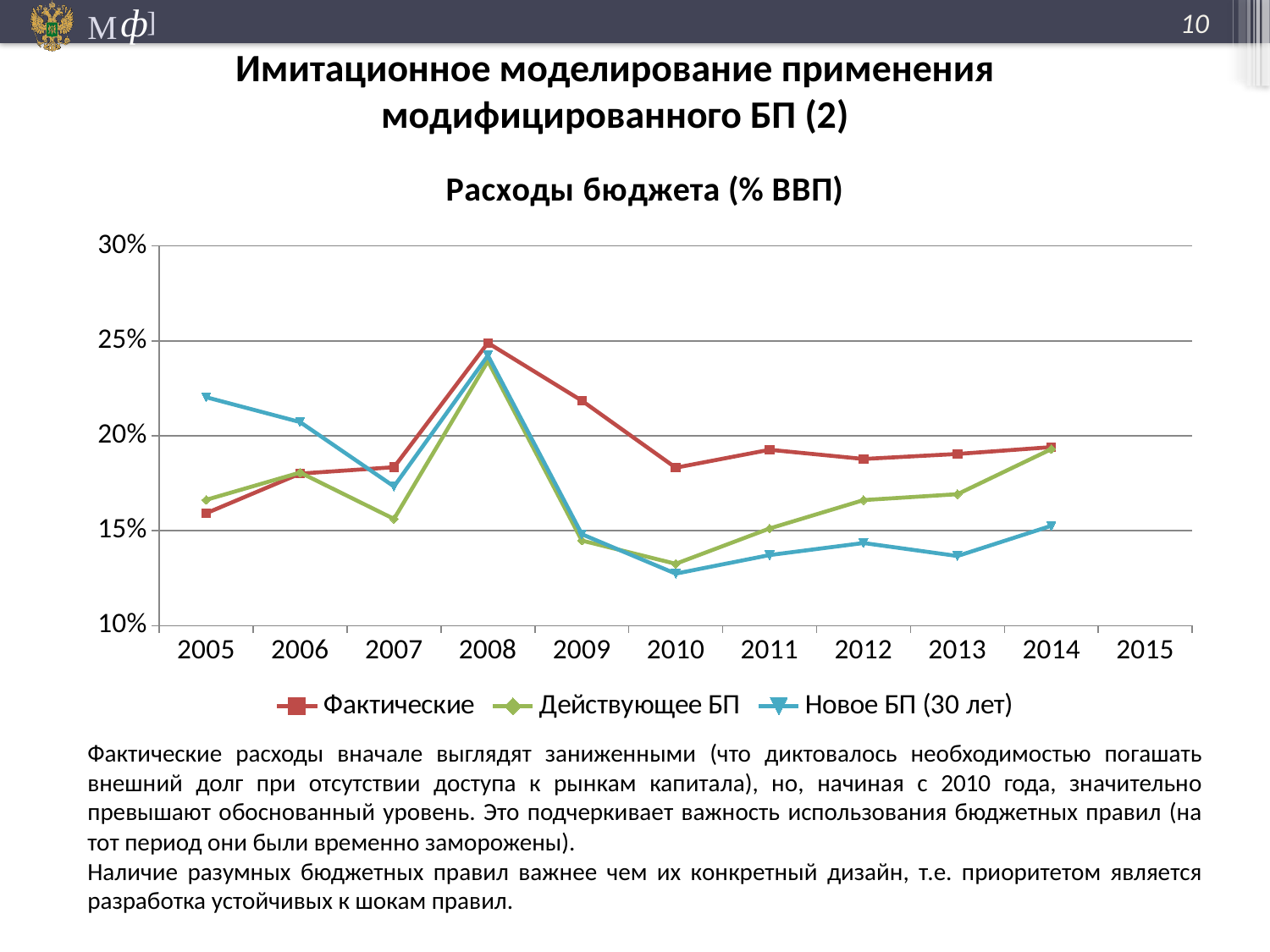
Is the value for Новое БП (30 лет) in 2010 greater or less than 15%? less In which year does the Новое БП (30 лет) series reach its lowest value? 2010 In 2010, which series has the larger value: Фактические or Новое БП (30 лет)? Фактические In 2005, which series has the larger value: Новое БП (30 лет) or Фактические? Новое БП (30 лет) What is the title of the chart? Расходы бюджета (% ВВП) Is the value for Фактические in 2008 greater or less than 20%? greater What kind of chart is shown on the slide? Line chart Is the value for Новое БП (30 лет) in 2005 greater or less than 20%? greater How many series does the chart legend list? 3 Does the Действующее БП series rise or fall from 2010 to 2014? Rise How many years are labeled on the x axis of the chart? 11 In which year does the Фактические series reach its highest value? 2008